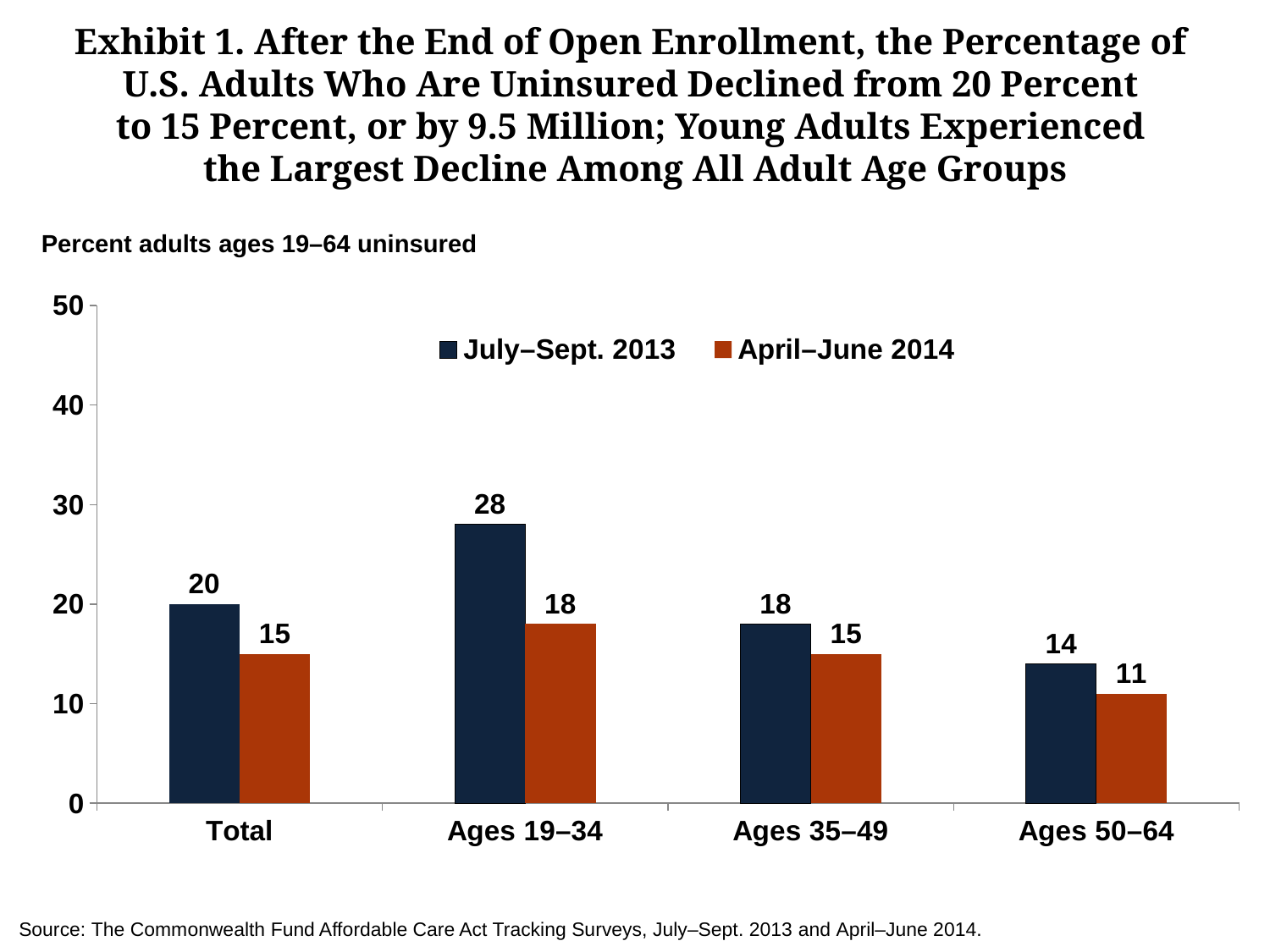
Which category has the highest July–Sept. 2013 value? Ages 19–34 What is the April–June 2014 value for Total? 15 What is the April–June 2014 value for Ages 50–64? 11 What is the difference between the July–Sept. 2013 values for Ages 35–49 and Ages 50–64? 4 What is the July–Sept. 2013 value for Ages 19–34? 28 Which is larger, the July–Sept. 2013 value for Total or the July–Sept. 2013 value for Ages 35–49? Total How many series does the legend list? 2 Which category has the lowest April–June 2014 value? Ages 50–64 How many age categories are shown on the x axis? 4 What is the difference between the July–Sept. 2013 and April–June 2014 values for Ages 19–34? 10 What is the label of the second series in the legend? April–June 2014 What kind of chart is shown on the slide? Bar chart